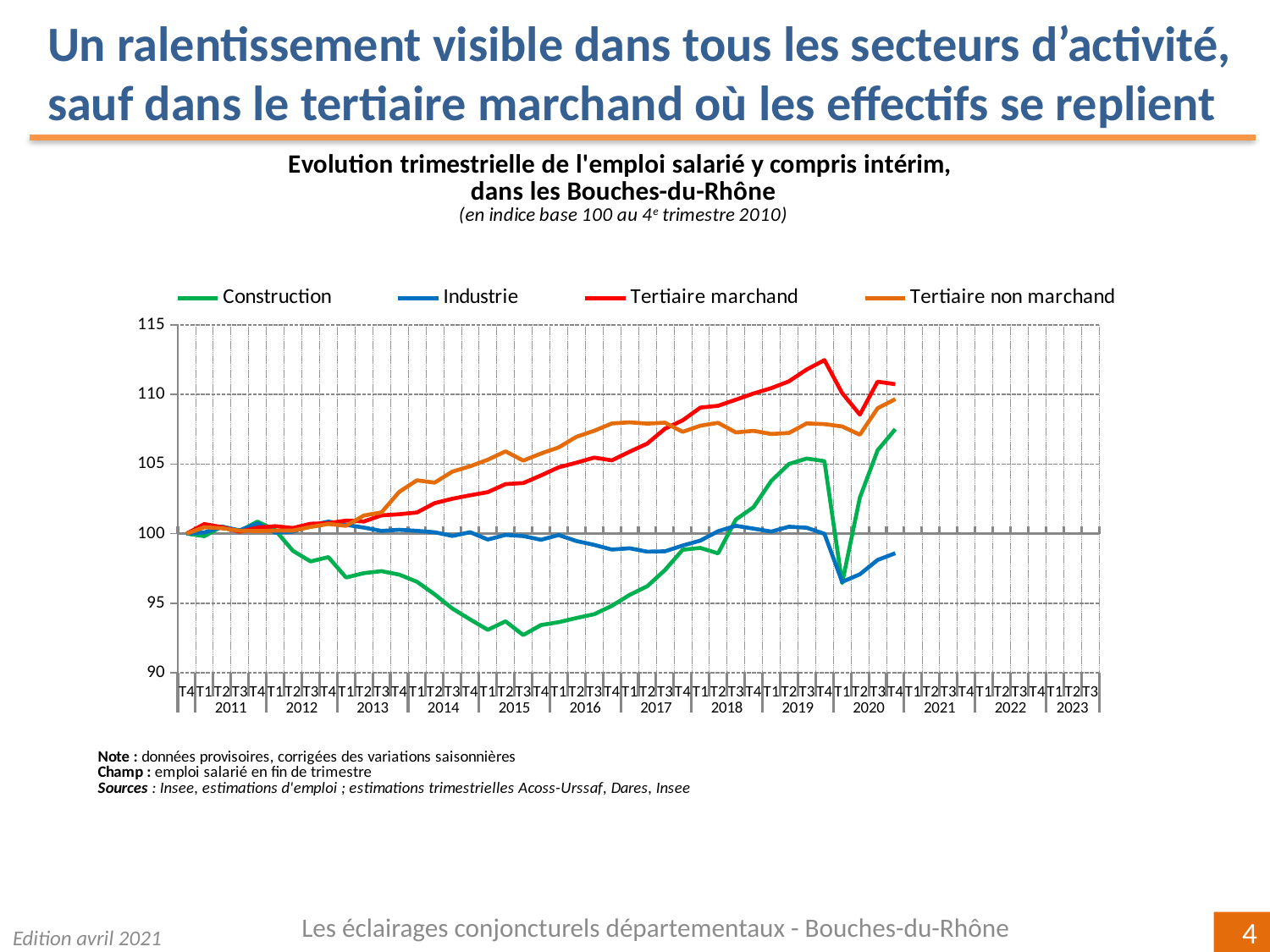
At the last plotted quarter (T4 2020), which is higher: Tertiaire marchand or Industrie? Tertiaire marchand Does the Tertiaire marchand series rise or fall between 2012 and 2019? Rise Which series reaches the highest value anywhere on the chart? Tertiaire marchand Is the value for Construction at T1 2015 greater or less than 95? less Does the Construction series rise or fall between 2011 and early 2015? Fall Is the value for Industrie at T1 2020 greater or less than 100? less How many series does the legend list? 4 Which series falls to the lowest value anywhere on the chart? Construction What kind of chart is shown on the slide? Line chart According to the chart subtitle, what is the base value of the index at the 4th quarter of 2010? 100 Is the value for Tertiaire marchand at T4 2019 greater or less than 110? greater Which series is drawn in green in the legend? Construction